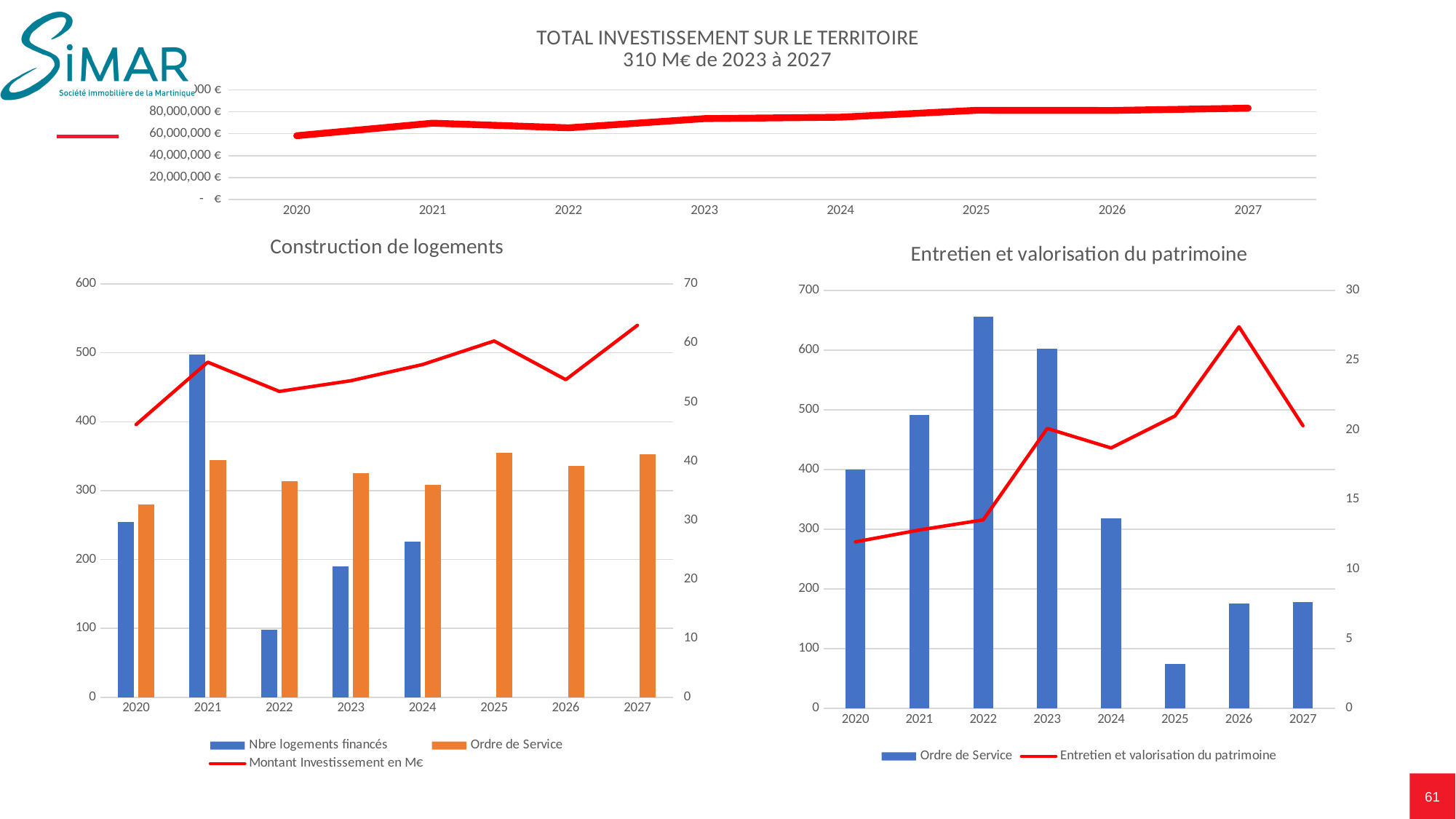
In the 'Construction de logements' chart, which year has the highest value for 'Nbre logements financés'? 2021 In the top chart 'TOTAL INVESTISSEMENT SUR LE TERRITOIRE', which year has the lowest value? 2020 In the top chart 'TOTAL INVESTISSEMENT SUR LE TERRITOIRE', is the value for 2027 greater or less than 60,000,000 €? greater In the 'Construction de logements' chart, is the value for 'Nbre logements financés' in 2021 greater or less than 400? greater In the 'Entretien et valorisation du patrimoine' chart, in which year does the 'Entretien et valorisation du patrimoine' line reach its highest point? 2026 In the 'Entretien et valorisation du patrimoine' chart, which year has the highest 'Ordre de Service' bar? 2022 In the 'Construction de logements' chart, which is larger in 2020: 'Nbre logements financés' or 'Ordre de Service'? Ordre de Service How many series does the legend of the 'Construction de logements' chart list? 3 How many years are shown on the x axis of the 'Construction de logements' chart? 8 What kind of chart is the top chart titled 'TOTAL INVESTISSEMENT SUR LE TERRITOIRE'? line chart In the 'Entretien et valorisation du patrimoine' chart, which year has the lowest 'Ordre de Service' bar? 2025 In the top chart 'TOTAL INVESTISSEMENT SUR LE TERRITOIRE', do the values generally rise or fall from 2020 to 2027? rise